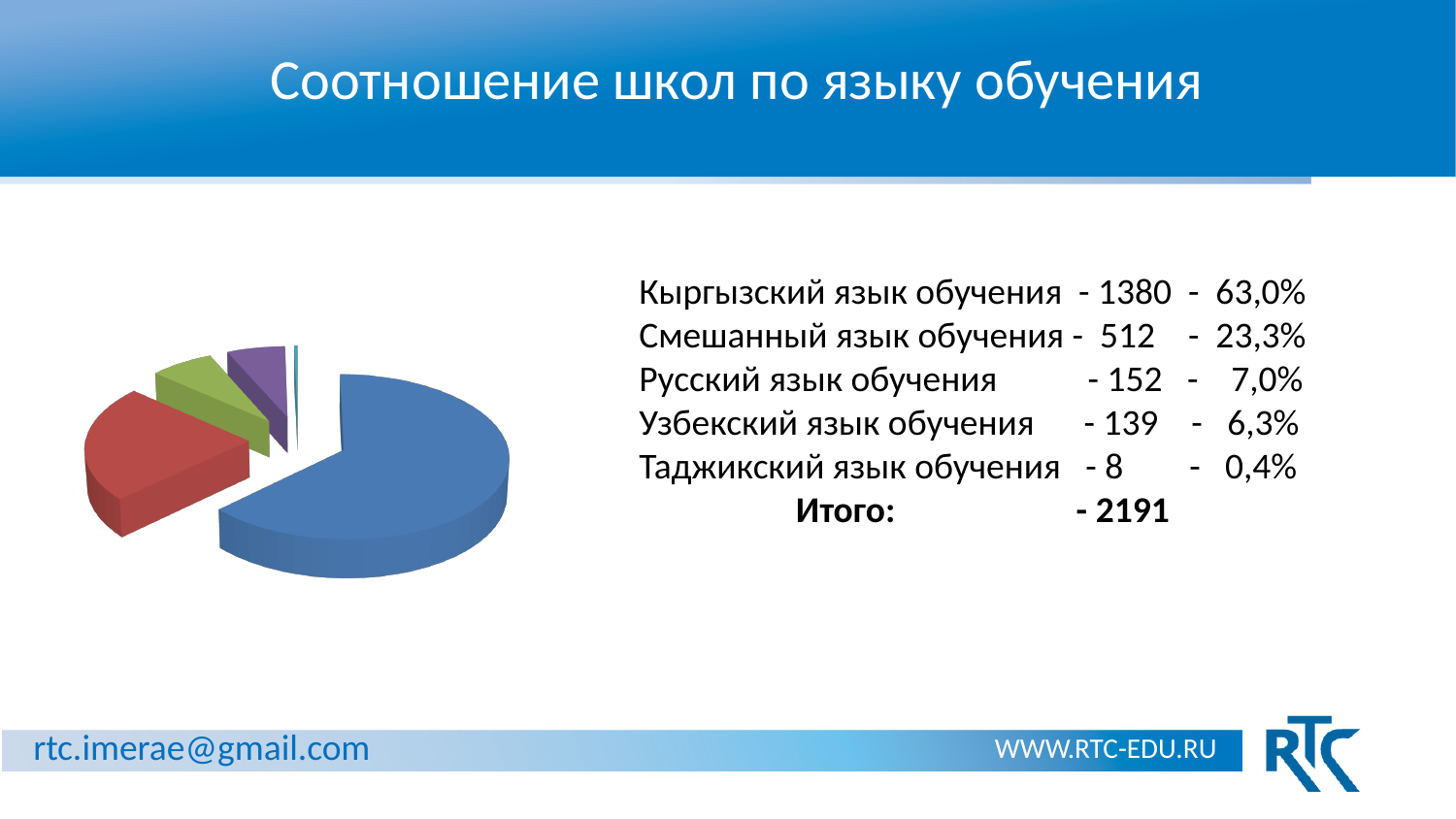
Which has more schools: Russian language of instruction or Uzbek language of instruction? Русский язык обучения What share of schools have Uzbek as the language of instruction (Узбекский язык обучения)? 6,3% Which language of instruction has the smallest number of schools? Таджикский язык обучения What share of schools have Russian as the language of instruction (Русский язык обучения)? 7,0% What is the difference between the number of schools with Kyrgyz and with mixed language of instruction? 868 Which language of instruction has the largest number of schools? Кыргызский язык обучения What is the title of the slide containing the pie chart? Соотношение школ по языку обучения What is the total number of schools (Итого)? 2191 What kind of chart is shown on the slide? pie chart How many schools have a mixed language of instruction (Смешанный язык обучения)? 512 How many schools have Kyrgyz as the language of instruction (Кыргызский язык обучения)? 1380 How many slices does the pie chart have? 5